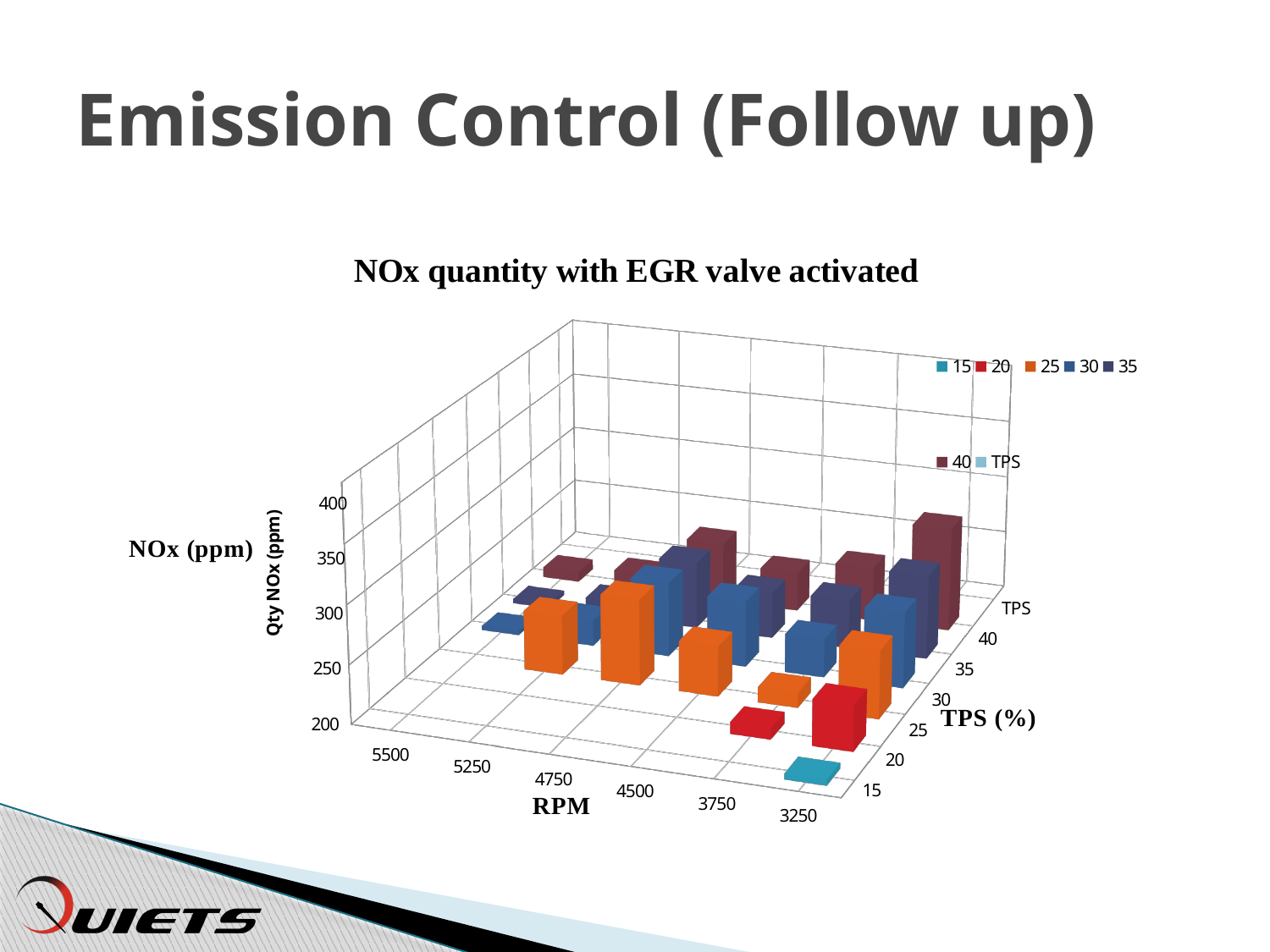
How many entries does the chart's legend list? 7 What is the lowest RPM value shown on the RPM axis? 3250 How many RPM categories are shown along the RPM axis? 6 What is the title of the chart? NOx quantity with EGR valve activated What kind of chart is shown on the slide? bar chart What is the highest value shown on the vertical axis of the chart? 400 What is the lowest value shown on the vertical axis of the chart? 200 What is the highest RPM value shown on the RPM axis? 5500 What is the label of the vertical axis of the chart? Qty NOx (ppm)